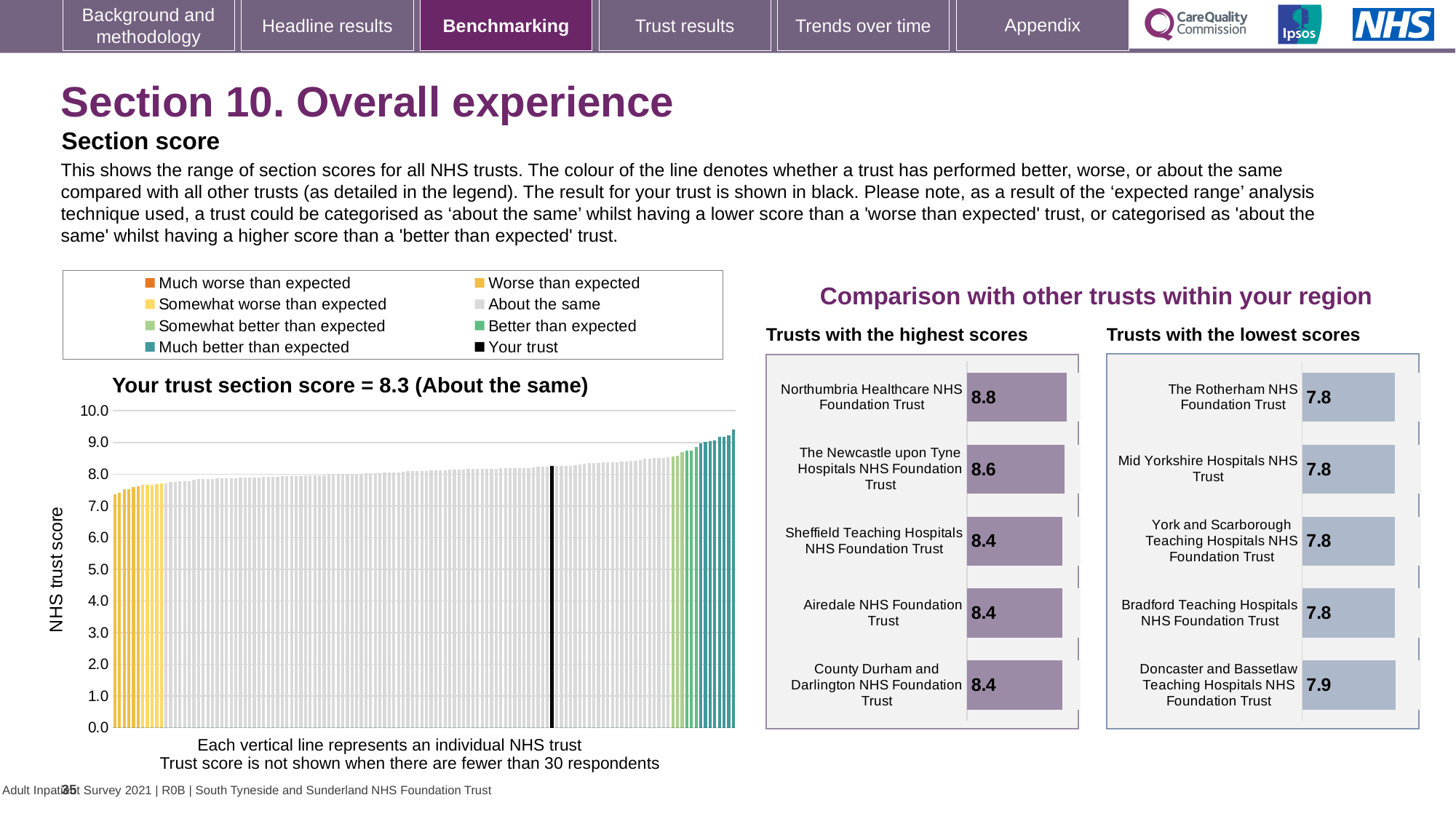
In the 'Your trust section score' chart, what is the section score for your trust? 8.3 In the 'Trusts with the highest scores' chart, what is the difference between the scores of Northumbria Healthcare NHS Foundation Trust and The Newcastle upon Tyne Hospitals NHS Foundation Trust? 0.2 In the 'Your trust section score' chart, is the value of the leftmost bar greater or less than 8.0? less In the 'Trusts with the lowest scores' chart, what is the score for Doncaster and Bassetlaw Teaching Hospitals NHS Foundation Trust? 7.9 In the 'Trusts with the highest scores' chart, what is the score for Northumbria Healthcare NHS Foundation Trust? 8.8 In the 'Your trust section score' chart, what is the label on the vertical axis? NHS trust score In the 'Your trust section score' chart, what kind of chart is shown? Bar chart In the 'Trusts with the highest scores' chart, which trust has the highest score? Northumbria Healthcare NHS Foundation Trust In the 'Your trust section score' chart, how many entries does the legend list? 8 In the 'Your trust section score' chart, do the bar values rise or fall from left to right? Rise In the 'Trusts with the lowest scores' chart, how many trusts are shown? 5 In the 'Your trust section score' chart, is the value of the rightmost bar greater or less than 9.0? greater